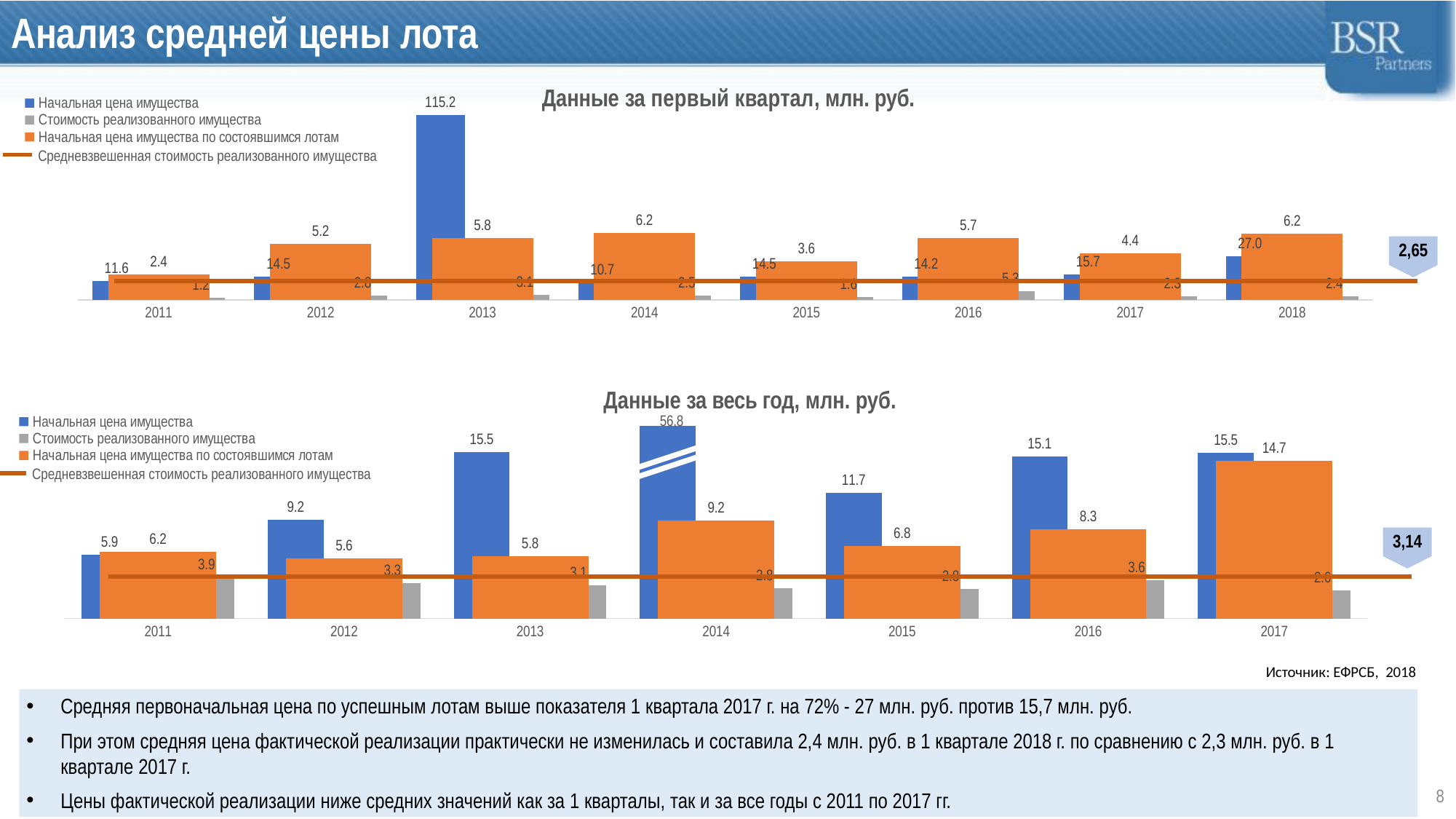
In the chart 'Данные за первый квартал, млн. руб.', what is the difference between 'Начальная цена имущества' for 2018 and for 2017? 11.3 In the chart 'Данные за весь год, млн. руб.', what is the value of 'Начальная цена имущества по состоявшимся лотам' for 2017? 14.7 In the chart 'Данные за весь год, млн. руб.', which is larger for 2011: 'Начальная цена имущества' or 'Начальная цена имущества по состоявшимся лотам'? Начальная цена имущества по состоявшимся лотам In the chart 'Данные за первый квартал, млн. руб.', how many years are shown on the x axis? 8 How many series does the legend of the chart 'Данные за весь год, млн. руб.' list? 4 In the chart 'Данные за первый квартал, млн. руб.', what is the value of 'Начальная цена имущества' for 2013? 115.2 What kind of chart is 'Данные за весь год, млн. руб.'? Bar chart with a line In the chart 'Данные за первый квартал, млн. руб.', what is the value of 'Начальная цена имущества по состоявшимся лотам' for 2018? 6.2 In the chart 'Данные за первый квартал, млн. руб.', which year has the highest value of 'Начальная цена имущества'? 2013 In the chart 'Данные за весь год, млн. руб.', what is the value of 'Начальная цена имущества' for 2014? 56.8 In the chart 'Данные за первый квартал, млн. руб.', what value is shown for the line 'Средневзвешенная стоимость реализованного имущества'? 2,65 In the chart 'Данные за весь год, млн. руб.', which year has the lowest value of 'Начальная цена имущества по состоявшимся лотам'? 2012